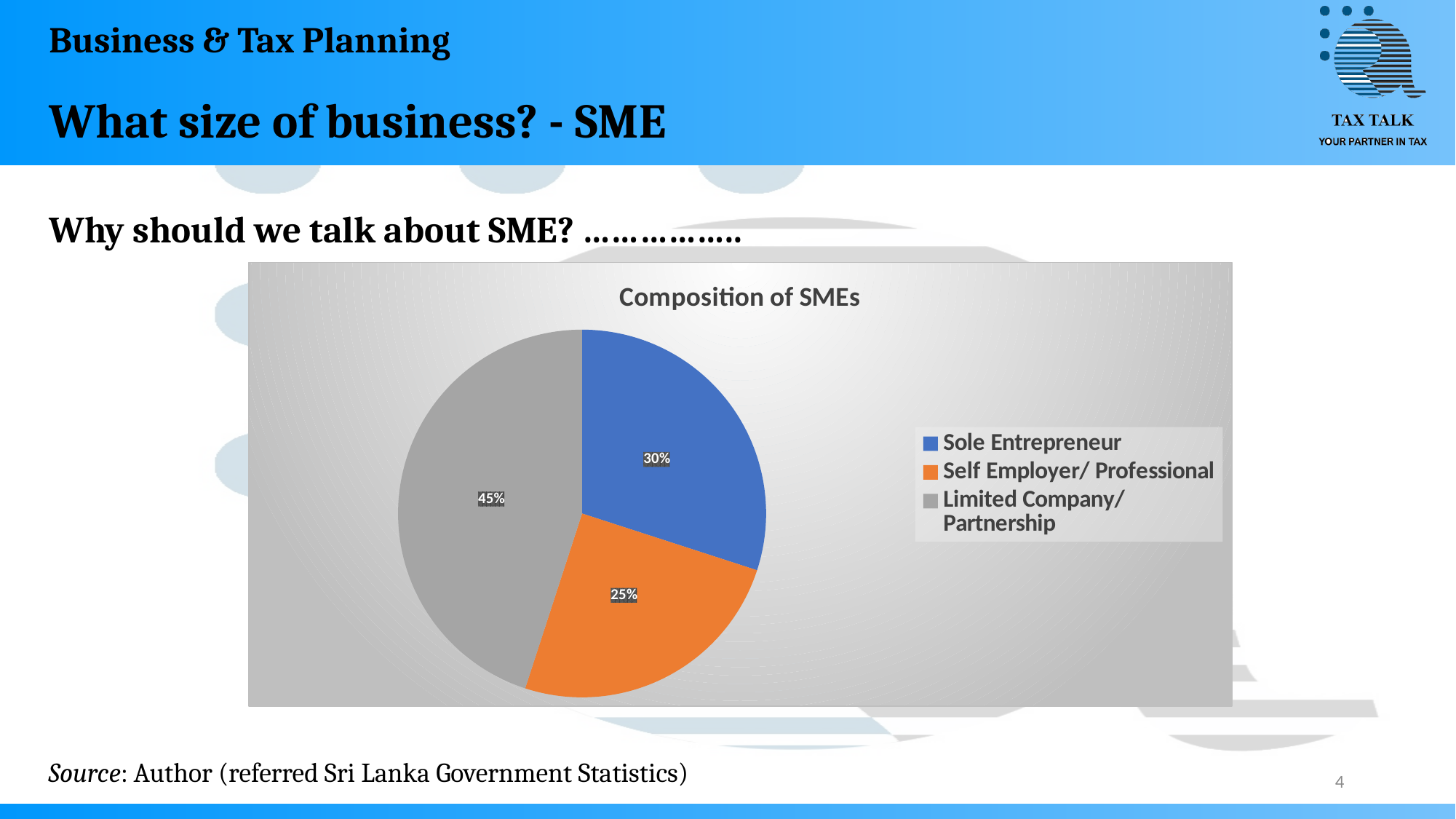
Which category has the largest share of the pie? Limited Company/ Partnership What kind of chart is shown on the slide? pie chart How many categories does the pie chart show? 3 Which category has the smallest share of the pie? Self Employer/ Professional What is the title of the chart? Composition of SMEs What is the difference in percentage points between Limited Company/ Partnership and Sole Entrepreneur? 15 What share of SMEs is Limited Company/ Partnership? 45% What colour is the slice for Self Employer/ Professional? orange What share of SMEs is Sole Entrepreneur? 30% Which is larger, the share for Sole Entrepreneur or the share for Self Employer/ Professional? Sole Entrepreneur What share of SMEs is Self Employer/ Professional? 25% What is the combined share of Sole Entrepreneur and Self Employer/ Professional? 55%